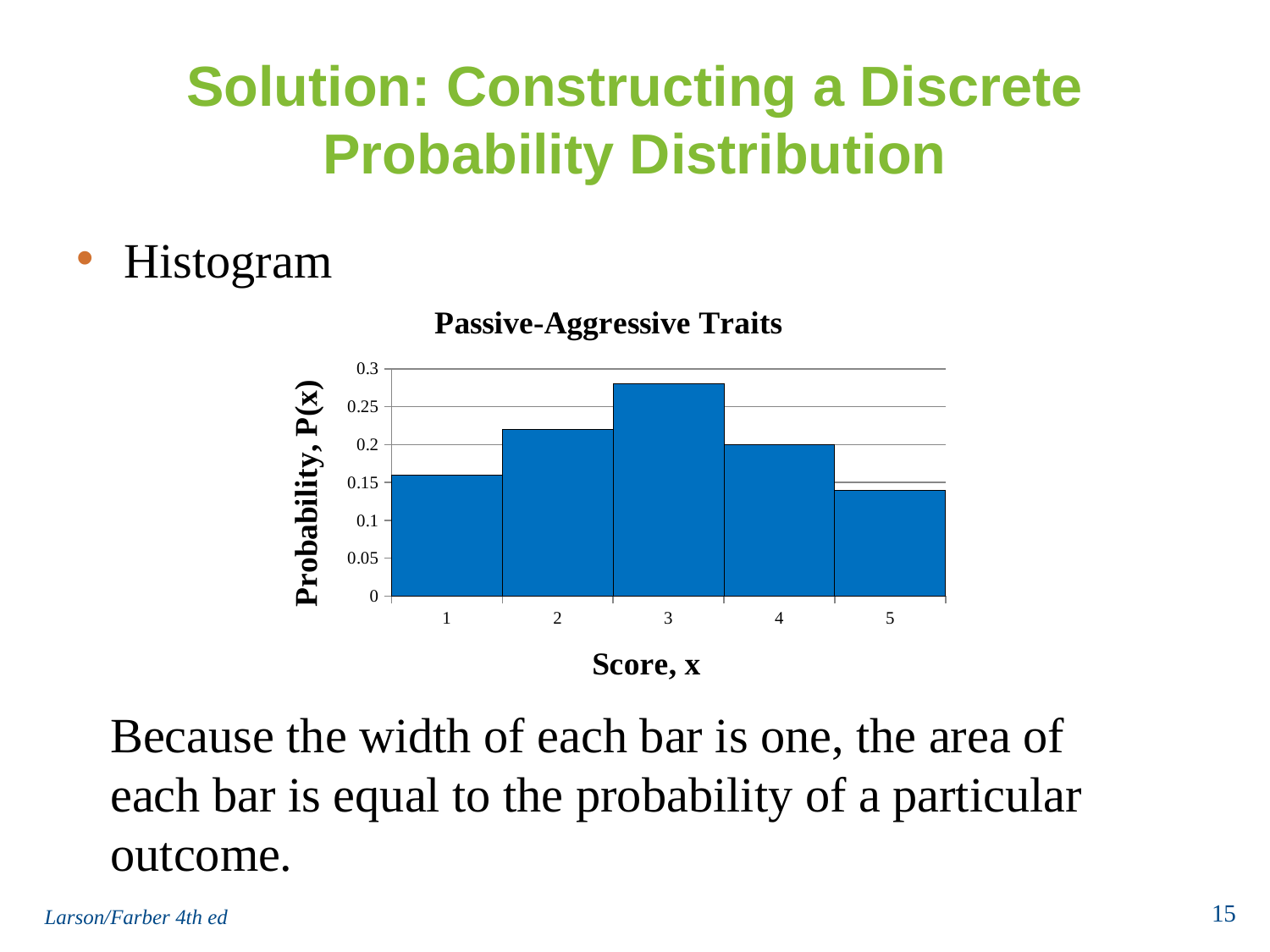
Is the probability for score 3 greater or less than 0.25? greater Is the probability for score 5 greater or less than 0.2? less Is the probability for score 1 greater or less than 0.2? less What is the title of the chart? Passive-Aggressive Traits Which score has the highest probability in the chart? 3 Do the probabilities rise or fall from score 3 to score 5? fall Which score has the lowest probability in the chart? 5 What kind of chart is shown on the slide? bar chart Which has the larger probability, score 1 or score 3? 3 What is the label of the y axis of the chart? Probability, P(x) How many score categories are shown on the x axis of the chart? 5